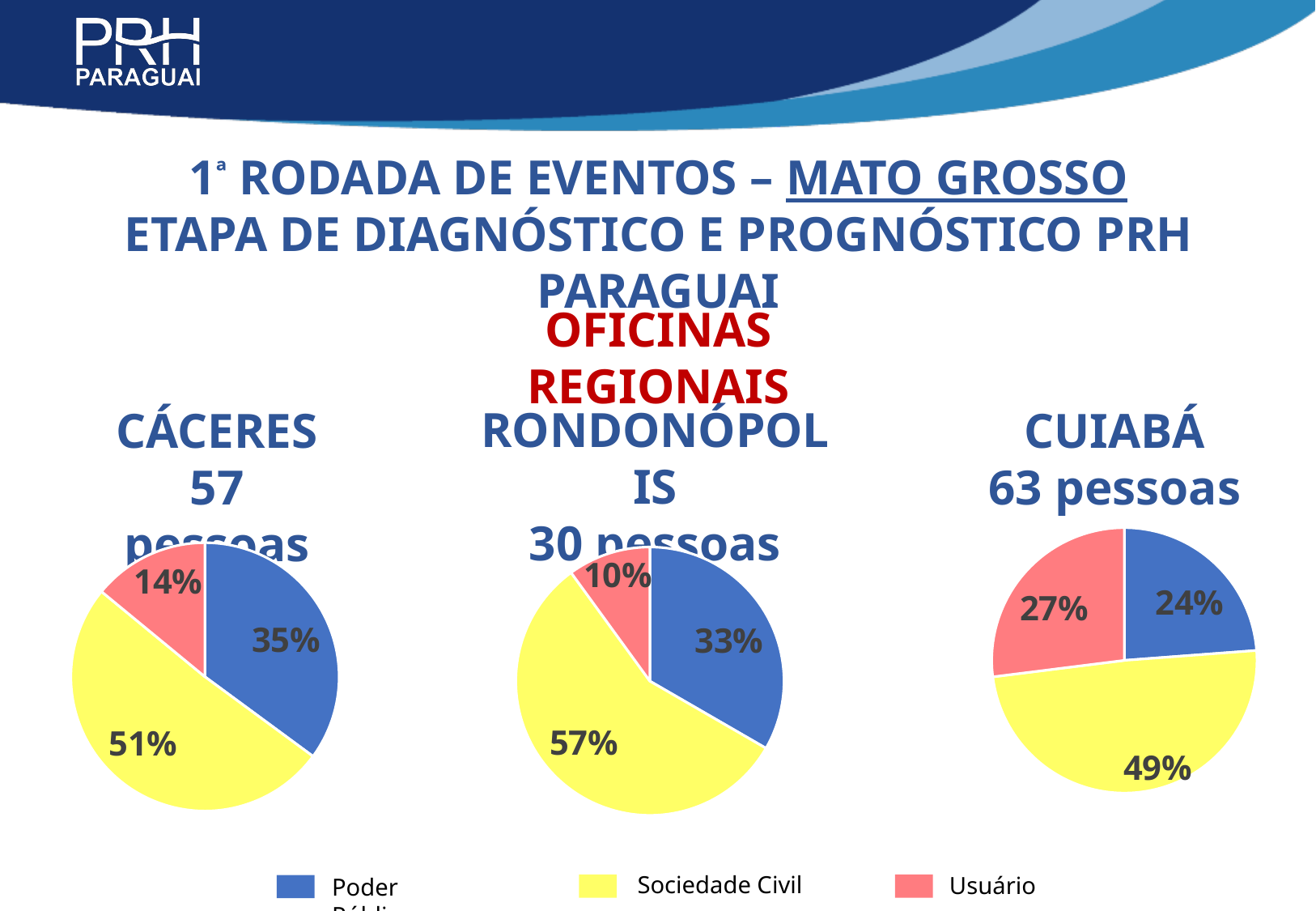
In the Rondonópolis pie chart, what is the difference between the Sociedade Civil share and the Usuário share? 47% In the Cuiabá pie chart, what share is Usuário? 27% How many pie charts are on the slide? 3 In the Cuiabá pie chart, what share is Sociedade Civil? 49% Which colour represents Sociedade Civil in the legend? Yellow How many slices does the Cáceres pie chart have? 3 What kind of charts are shown on the slide? Pie charts In the Cáceres pie chart, which category has the smallest slice? Usuário In the Cuiabá pie chart, which is larger: the Usuário slice or the blue Poder slice? Usuário In the Rondonópolis pie chart, which category has the largest slice? Sociedade Civil In the Rondonópolis pie chart, what share is Usuário? 10% In the Cáceres pie chart, what share is Sociedade Civil? 51%